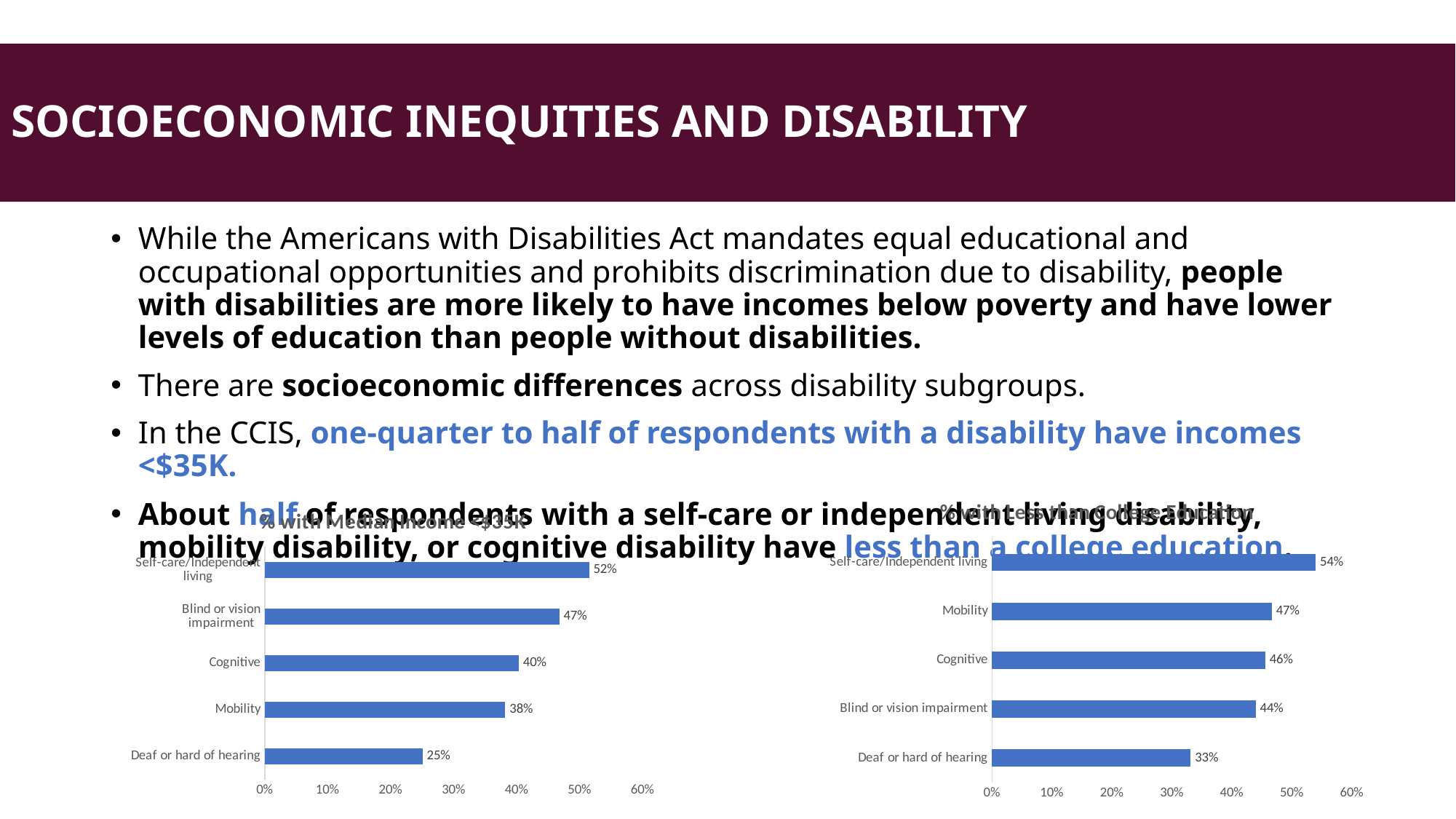
How many categories are shown in the right chart? 5 In the right chart, is the value for Deaf or hard of hearing greater or less than 40%? less In the left chart, which is larger: Blind or vision impairment or Mobility? Blind or vision impairment In the right chart, what is the difference between Self-care/Independent living and Cognitive? 8% In the right chart, what is the value for Mobility? 47% In the left chart, what is the value for Deaf or hard of hearing? 25% What kind of chart is the left chart? Bar chart In the right chart, what is the value for Blind or vision impairment? 44% In the left chart, what is the value for Cognitive? 40% In the left chart, which category has the highest value? Self-care/Independent living In the left chart, what is the difference between Self-care/Independent living and Deaf or hard of hearing? 27% In the right chart, which category has the lowest value? Deaf or hard of hearing